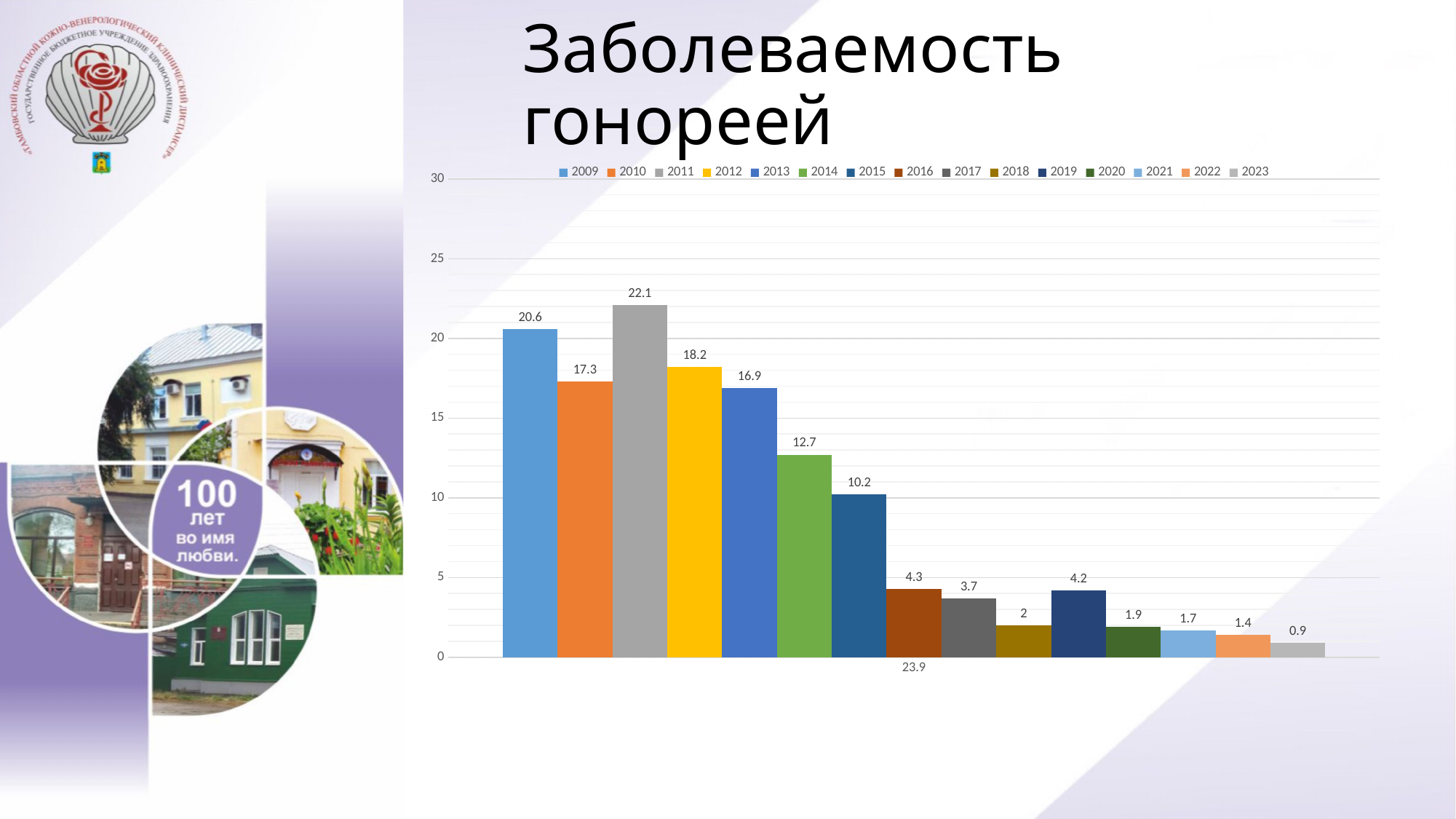
What is the value for 2015? 10.2 What is the value for 2011? 22.1 Which year has the lowest value? 2023 How many series does the legend list? 15 What is the value for 2023? 0.9 Is the value for 2014 greater or less than 10? greater Do the values generally rise or fall from 2011 to 2023? Fall What is the title of the chart? Заболеваемость гонореей Which year has the highest value? 2011 Which is larger, the value for 2016 or the value for 2019? 2016 What is the difference between the values for 2009 and 2010? 3.3 What kind of chart is shown on the slide? Bar chart